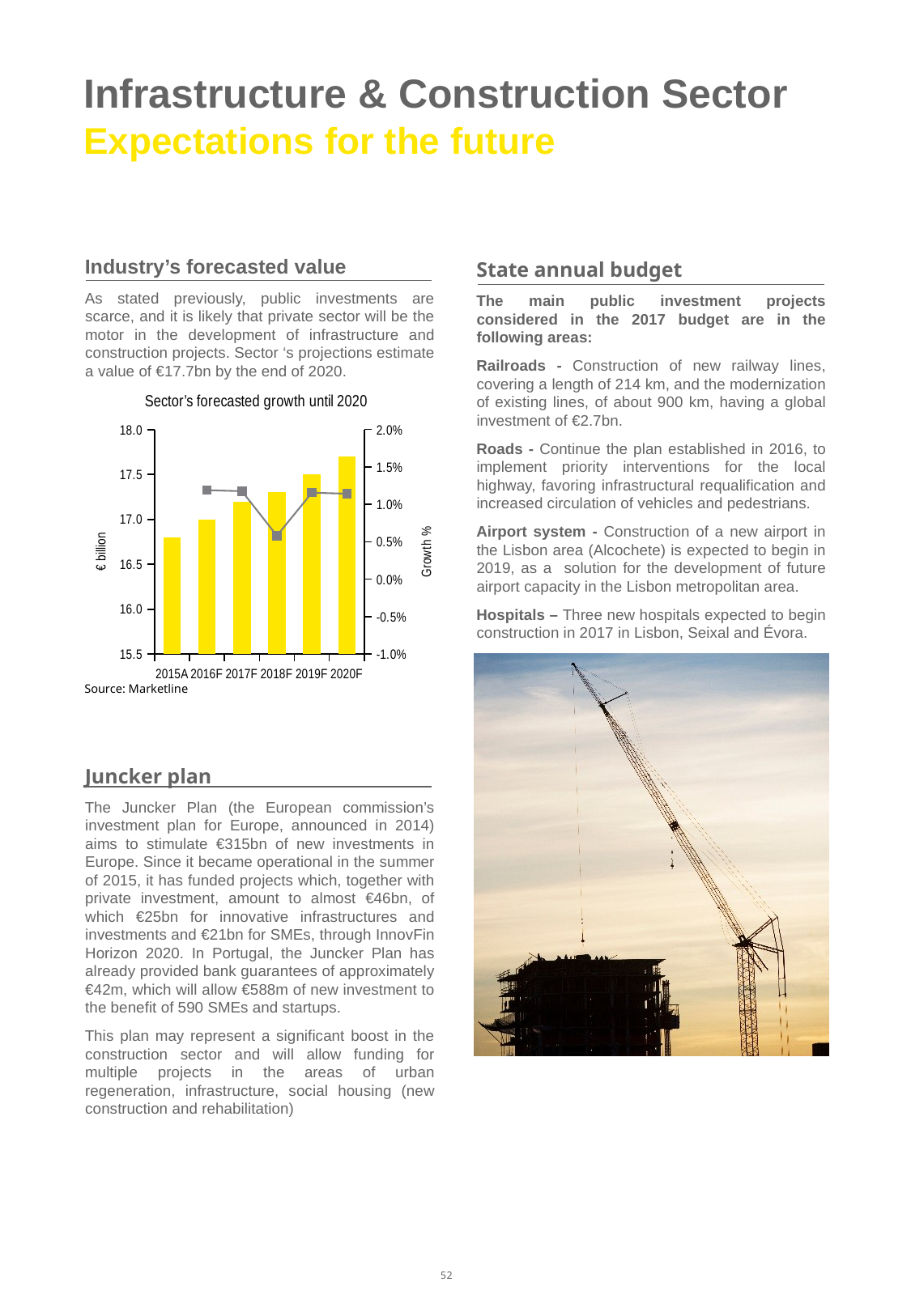
In the 'Sector's forecasted growth until 2020' chart, is the growth % for 2018F greater or less than 1.0%? less What is the label of the left vertical axis in the 'Sector's forecasted growth until 2020' chart? € billion In the 'Sector's forecasted growth until 2020' chart, which bar is taller, 2017F or 2019F? 2019F Do the bars in the 'Sector's forecasted growth until 2020' chart rise or fall from 2015A to 2020F? rise In the 'Sector's forecasted growth until 2020' chart, which year has the tallest bar? 2020F How many years are shown on the x axis of the 'Sector's forecasted growth until 2020' chart? 6 What kind of chart is 'Sector's forecasted growth until 2020'? bar chart with a line In the 'Sector's forecasted growth until 2020' chart, is the bar value for 2015A greater or less than 17.0? less In the 'Sector's forecasted growth until 2020' chart, which year has the lowest point on the growth % line? 2018F In the 'Sector's forecasted growth until 2020' chart, which year has the shortest bar? 2015A What source is cited below the 'Sector's forecasted growth until 2020' chart? Marketline In the 'Sector's forecasted growth until 2020' chart, is the bar value for 2020F greater or less than 17.5? greater